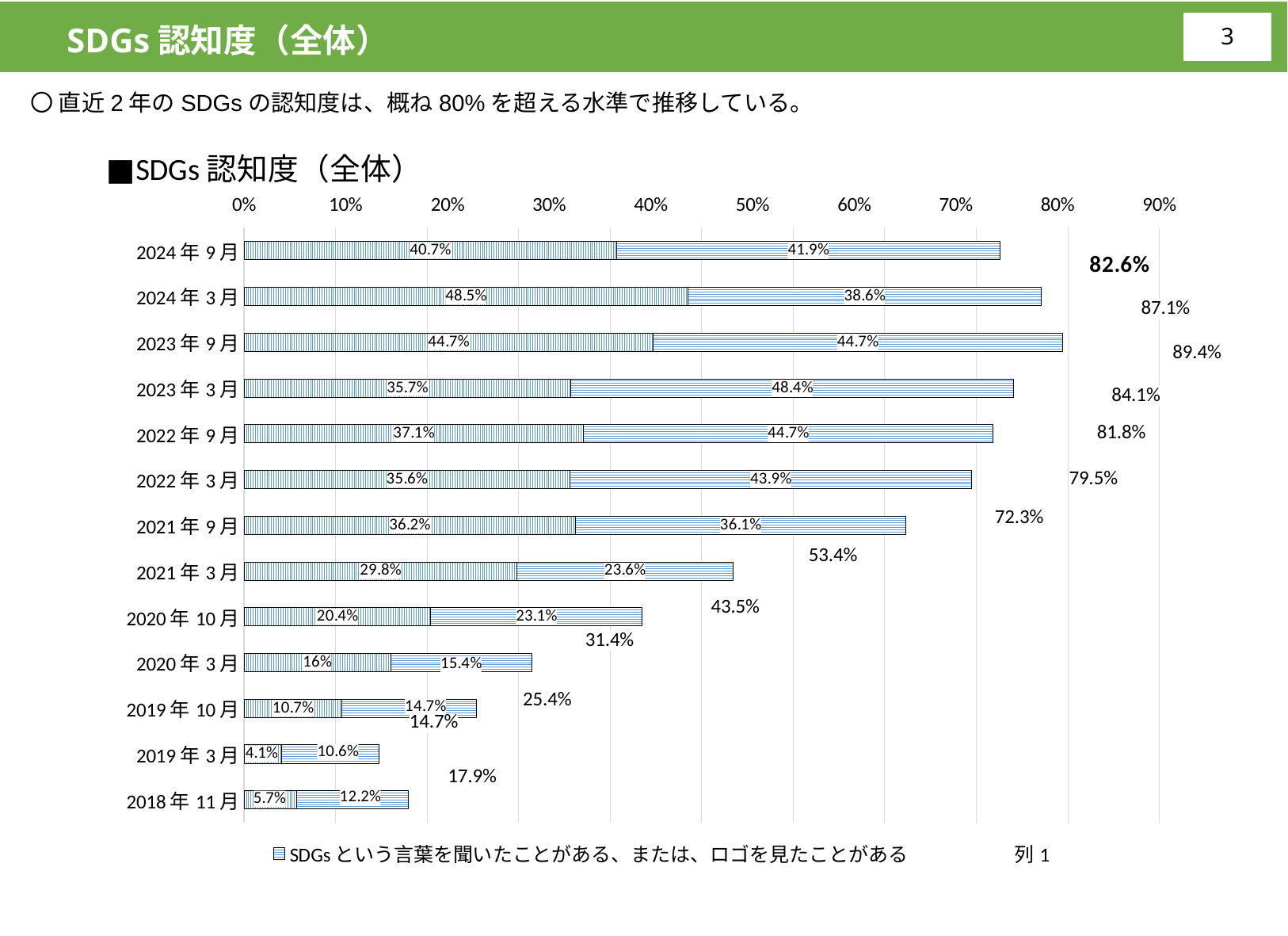
What kind of chart is shown on the slide? Stacked bar chart What is the total of the two segments for 2022年9月? 81.8% What is the value of the 列1 segment for 2023年3月? 84.1% Which is larger: the 列1 value for 2021年9月 or for 2021年3月? 2021年9月 How many survey periods (categories) are shown on the chart? 13 What is the difference between the first-segment values for 2024年3月 and 2024年9月? 7.8% Does total SDGs awareness generally rise or fall from 2018年11月 to 2023年9月? Rise Which survey period has the lowest value for the first segment (SDGsという言葉を聞いたことがある、または、ロゴを見たことがある)? 2019年3月 How many series does the legend list? 2 What is the total awareness value shown for 2024年3月? 87.1% Which survey period has the highest total awareness? 2023年9月